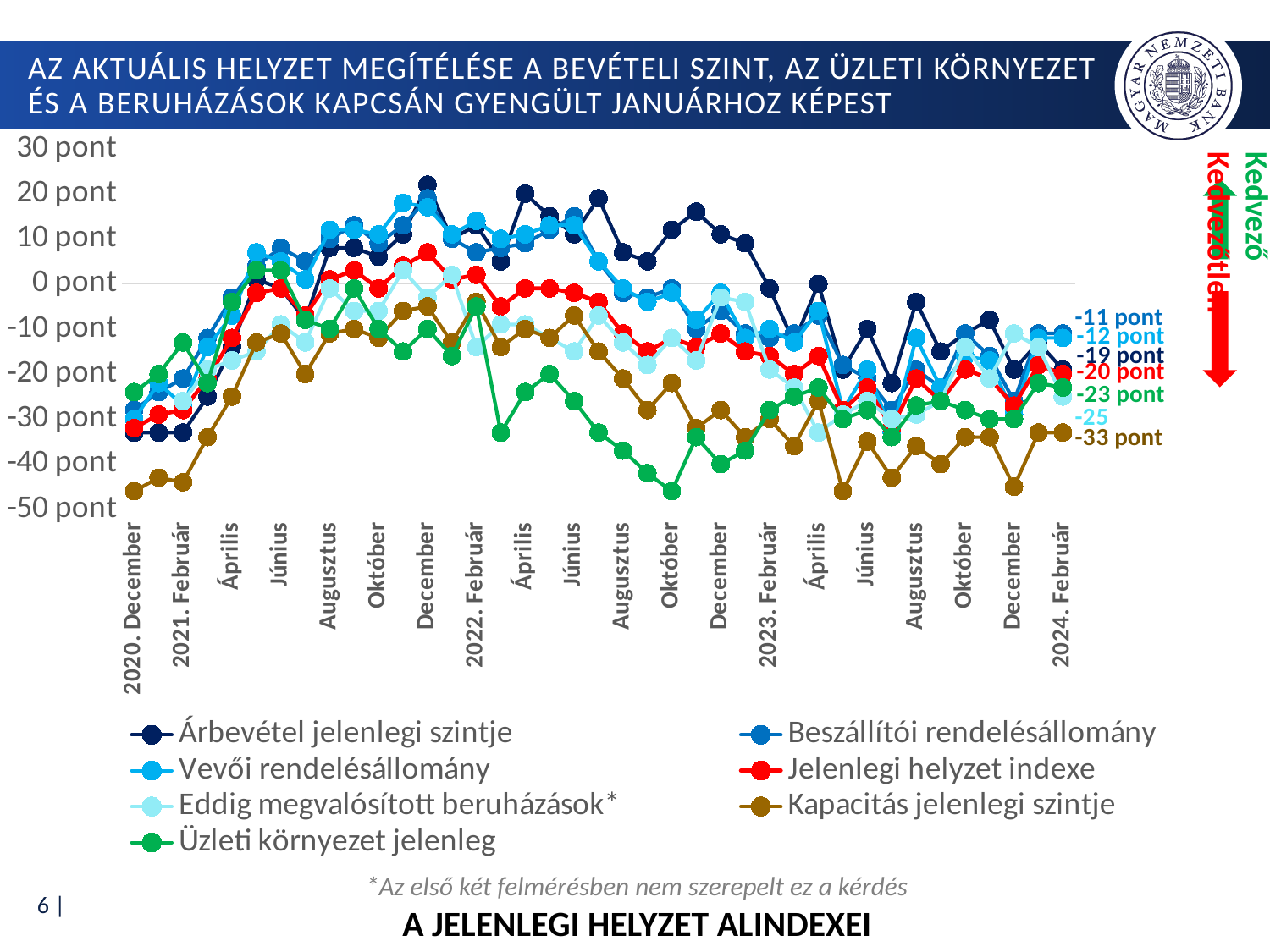
Does the Kapacitás jelenlegi szintje series rise or fall between 2020. December and 2021. Június? rise What kind of chart is shown on the slide? line chart Is the value of Kapacitás jelenlegi szintje in 2020. December greater or less than -40 pont? less What is the value of Kapacitás jelenlegi szintje at the end of the series (2024. Február)? -33 pont What is the difference between the end values of Beszállítói rendelésállomány (-11 pont) and Kapacitás jelenlegi szintje (-33 pont)? 22 pont What is the value of Üzleti környezet jelenleg at the end of the series (2024. Február)? -23 pont Which series has the highest value at the end of the series (2024. Február)? Beszállítói rendelésállomány What is the value of Beszállítói rendelésállomány at the end of the series (2024. Február)? -11 pont How many series does the legend list? 7 What is the title shown below the chart? A JELENLEGI HELYZET ALINDEXEI Which series has the lowest value at the end of the series (2024. Február)? Kapacitás jelenlegi szintje What is the value of Jelenlegi helyzet indexe at the end of the series (2024. Február)? -20 pont